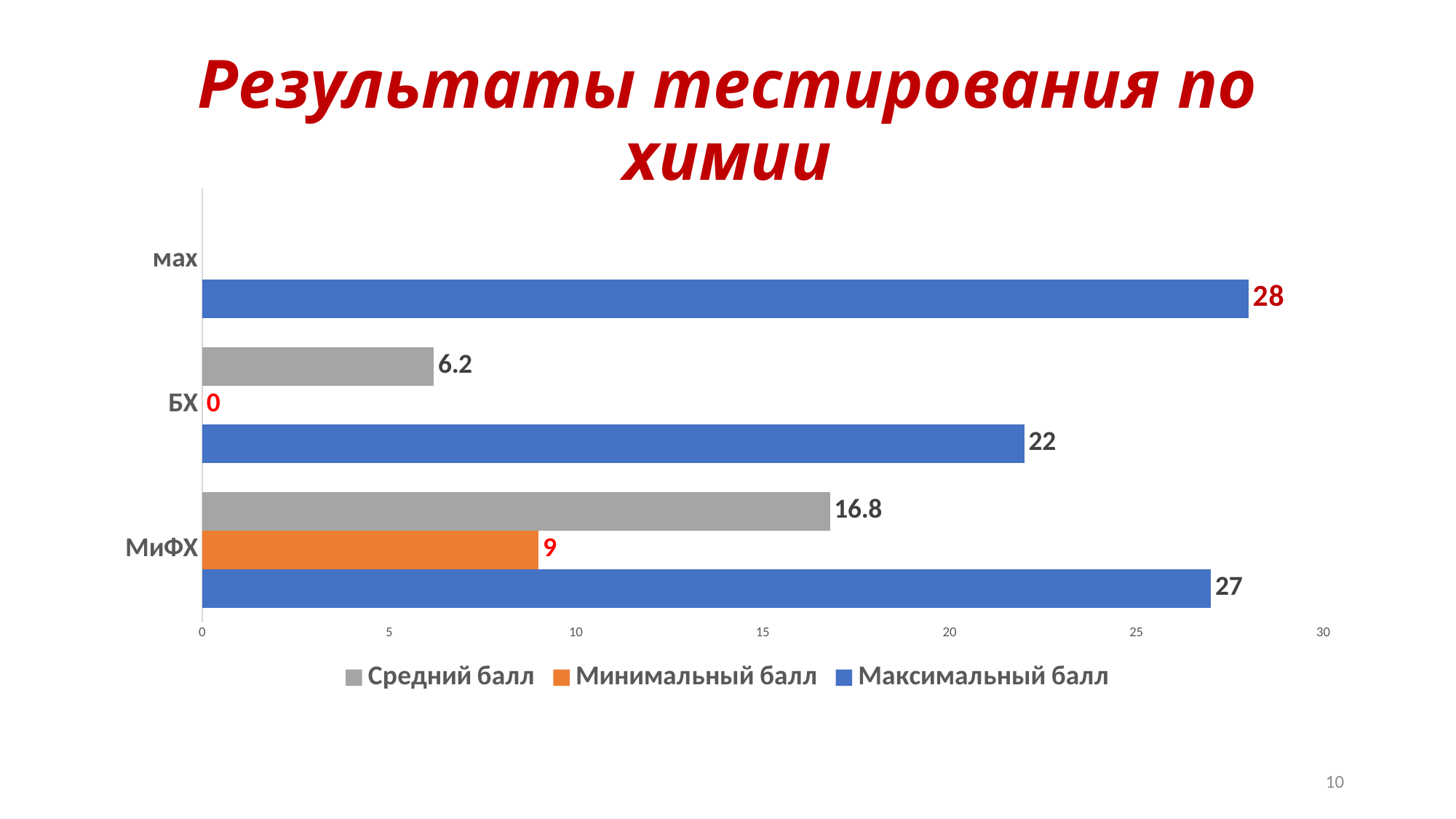
What is the Средний балл value for МиФХ? 16.8 How many series does the legend list? 3 What is the Минимальный балл value for БХ? 0 What is the Максимальный балл value for МиФХ? 27 What kind of chart is shown on the slide? Bar chart What is the Минимальный балл value for МиФХ? 9 Which is larger: the Средний балл for МиФХ or for БХ? МиФХ What is the title of the slide? Результаты тестирования по химии What is the Максимальный балл value for мах? 28 Which category has the highest Максимальный балл? мах What is the difference between the Максимальный балл for МиФХ and for БХ? 5 What is the Средний балл value for БХ? 6.2